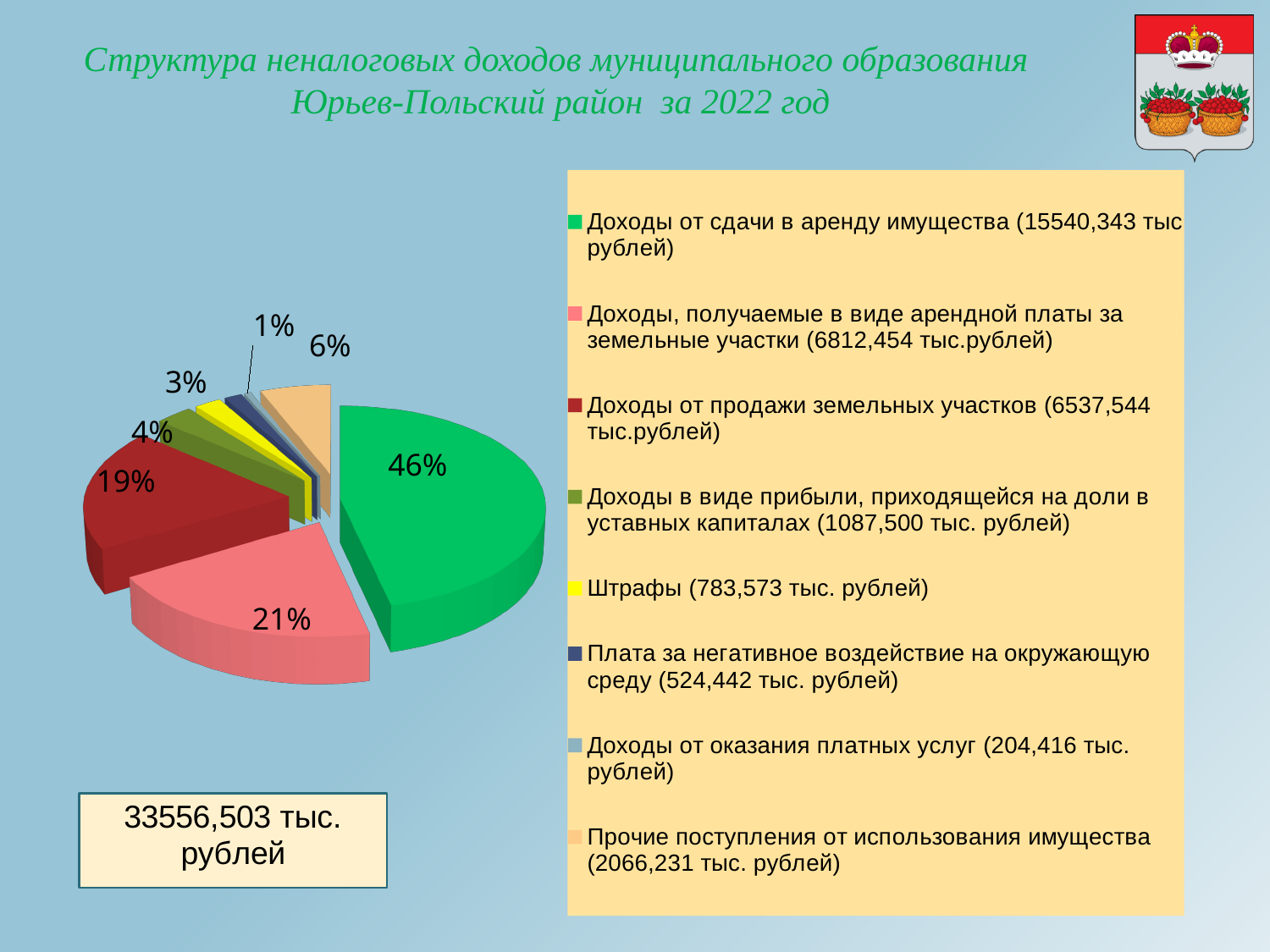
What share of the pie is labelled for Доходы от продажи земельных участков (dark red slice)? 19% How many categories does the legend of the pie chart list? 8 What share of the pie is labelled for Прочие поступления от использования имущества (beige slice)? 6% What share of the pie is labelled for Доходы от сдачи в аренду имущества (green slice)? 46% Which is larger: the share for Доходы от сдачи в аренду имущества or the share for Доходы от продажи земельных участков? Доходы от сдачи в аренду имущества According to the legend, what is the value for Доходы от сдачи в аренду имущества? 15540,343 тыс рублей What kind of chart is shown on the slide? pie chart Which category has the largest share of the pie? Доходы от сдачи в аренду имущества Which category has the smallest value according to the legend? Доходы от оказания платных услуг What total amount is shown in the box below the pie chart? 33556,503 тыс. рублей According to the legend, what is the value for Штрафы? 783,573 тыс. рублей